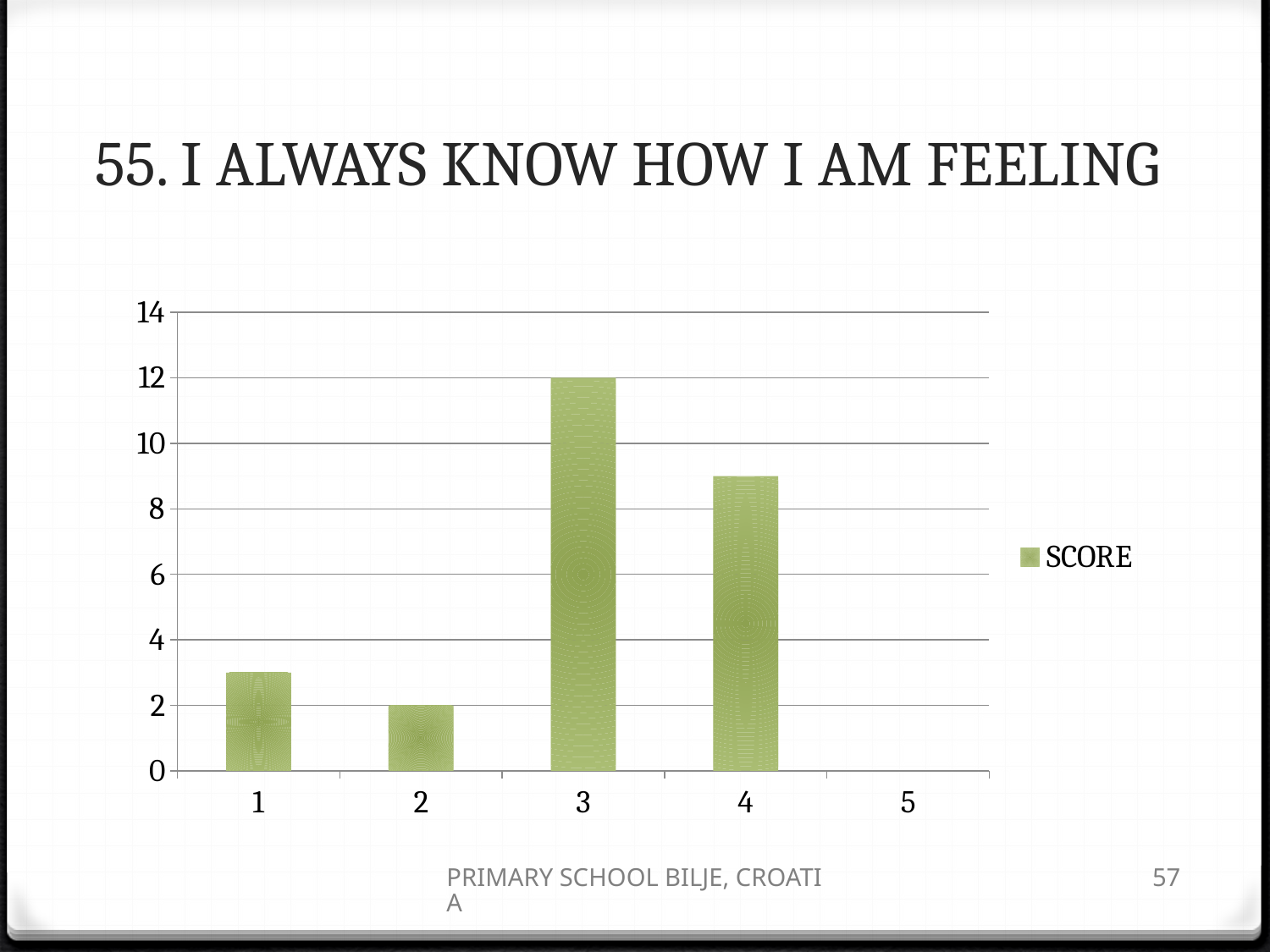
Which category has the highest value? 3 How many series does the legend list? 1 What is the value for category 3? 12 Is the value for category 4 greater or less than 8? greater How many categories are shown on the x axis? 5 What type of chart is shown on the slide? bar chart What is the difference between the values for category 3 and category 2? 10 What is the value for category 2? 2 Which has the larger value, category 3 or category 4? 3 What is the name of the series shown in the legend? SCORE Which has the larger value, category 1 or category 2? 1 Is the value for category 1 greater or less than 4? less